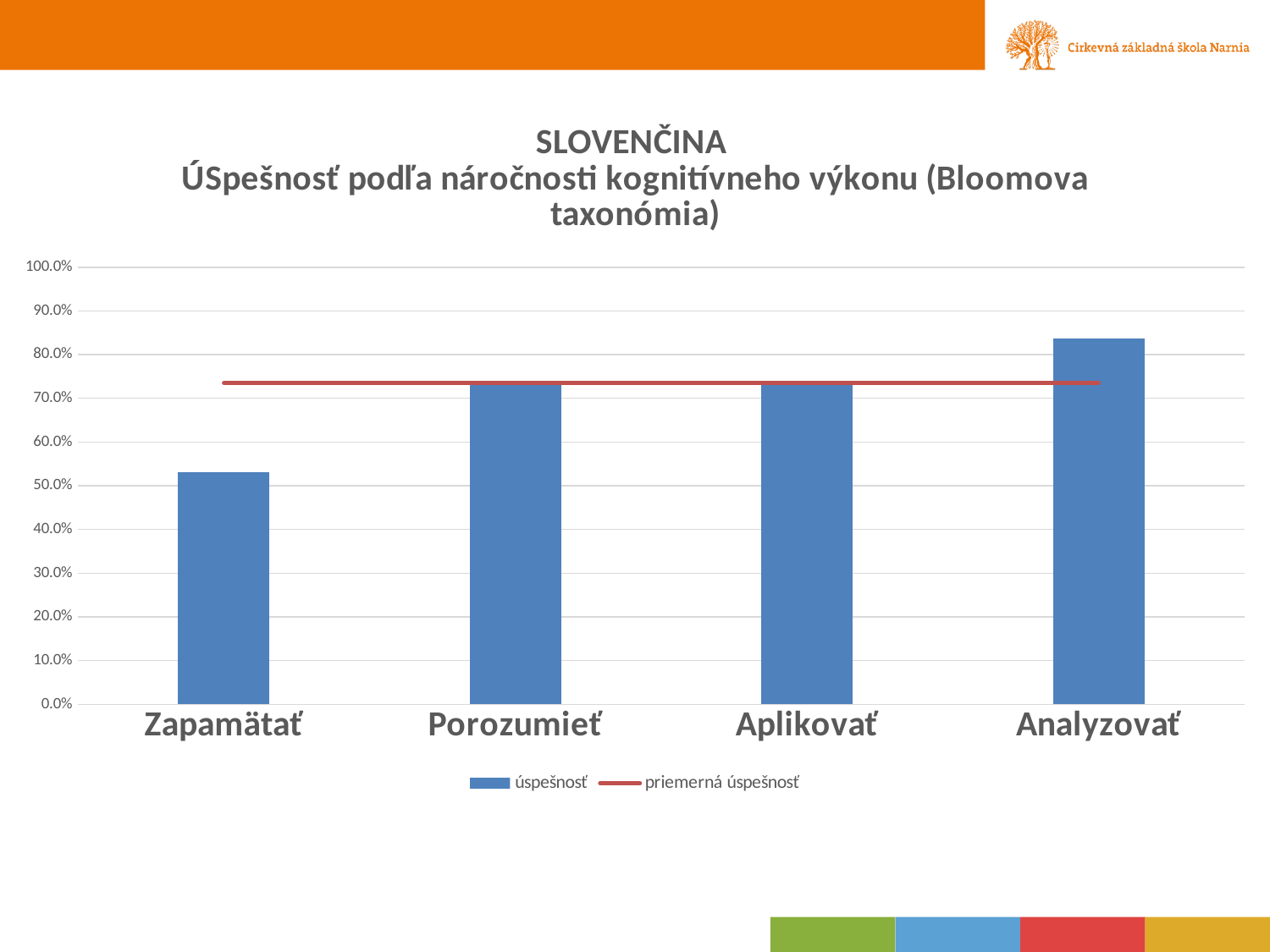
How many series does the chart legend list? 2 What kind of chart is shown on the slide? combination bar and line chart Which has a larger úspešnosť value, Zapamätať or Analyzovať? Analyzovať Is the úspešnosť value for Aplikovať greater or less than 80.0%? less What does the red line in the chart represent according to the legend? priemerná úspešnosť How many categories are shown on the x axis of the chart? 4 Which category has the lowest úspešnosť value? Zapamätať Which category has the highest úspešnosť value? Analyzovať Is the úspešnosť value for Analyzovať greater or less than 80.0%? greater Is the úspešnosť value for Porozumieť greater or less than 70.0%? greater Do the úspešnosť bars generally rise or fall from Zapamätať to Analyzovať? rise